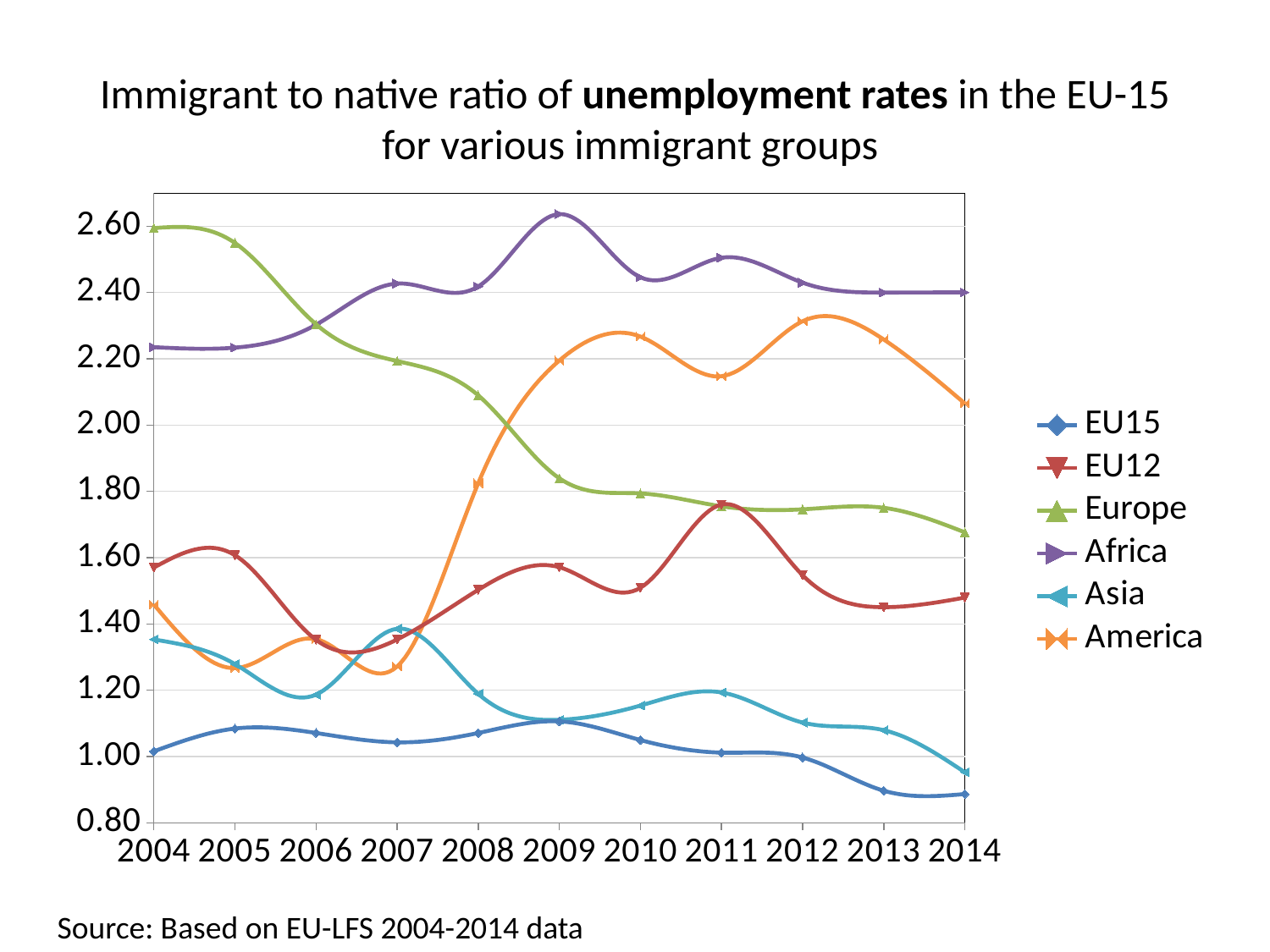
How many years are plotted along the x axis? 11 Does the ratio for Europe rise or fall from 2004 to 2014? fall In 2014, which is higher: the ratio for America or for Europe? America Is the value for Africa in 2009 greater or less than 2.40? greater How many series does the legend list? 6 Which immigrant group has the highest ratio in 2004? Europe Which immigrant group has the lowest ratio in 2014? EU15 Is the value for EU15 in 2014 greater or less than 1.00? less In 2004, which is higher: the ratio for Europe or for Africa? Europe What kind of chart is shown on the slide? line chart Which immigrant group has the highest ratio in 2009? Africa Is the value for America in 2004 greater or less than 1.60? less